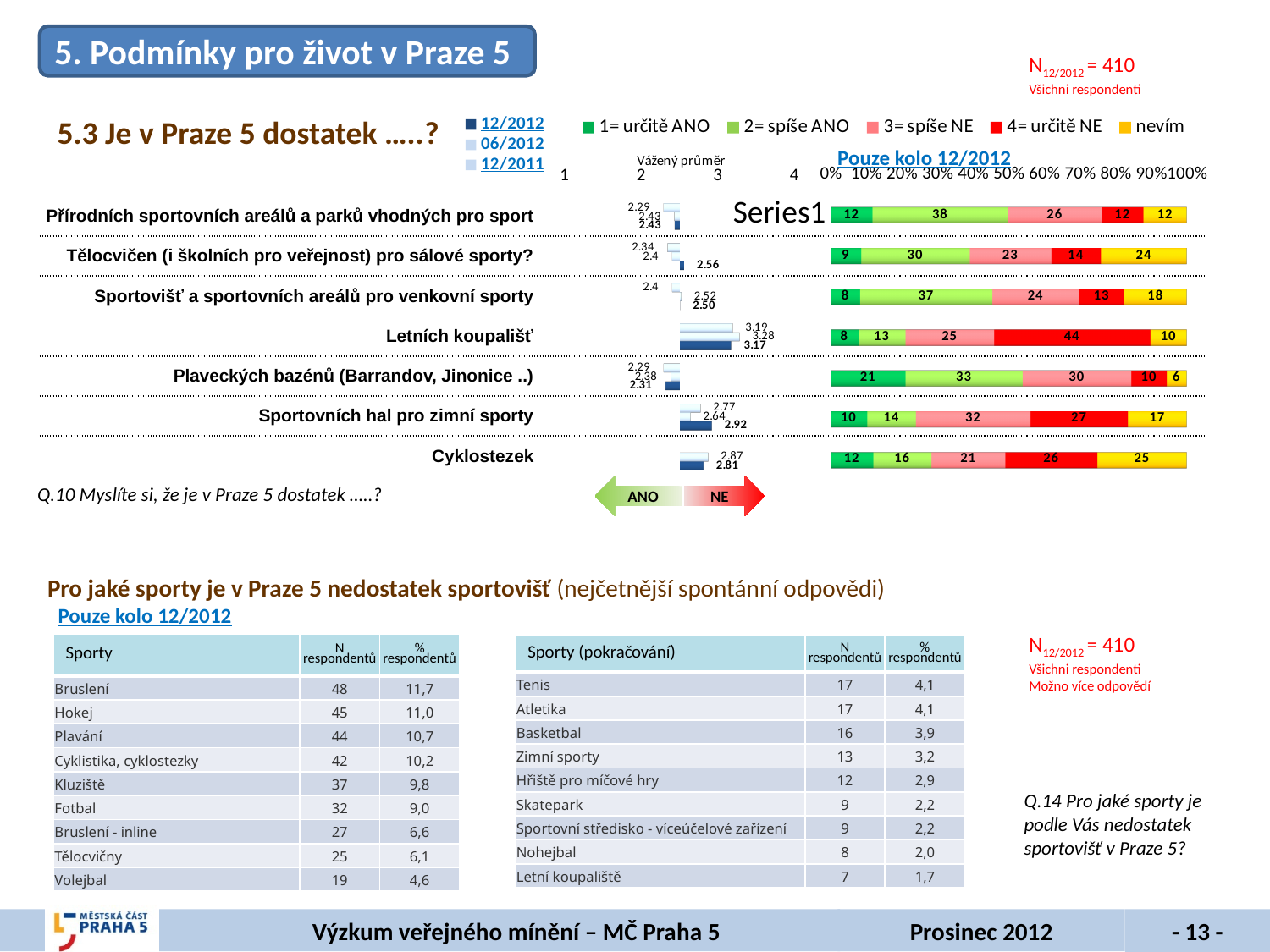
How many categories are shown in the stacked bar chart 'Pouze kolo 12/2012'? 7 In the stacked bar chart 'Pouze kolo 12/2012', which category has the lowest value for 'nevím'? Plaveckých bazénů (Barrandov, Jinonice ..) In the stacked bar chart 'Pouze kolo 12/2012', which category has the highest value for '2= spíše ANO'? Přírodních sportovních areálů a parků vhodných pro sport How many series does the legend of the stacked bar chart 'Pouze kolo 12/2012' list? 5 In the stacked bar chart 'Pouze kolo 12/2012', which has the larger 'nevím' value: 'Tělocvičen (i školních pro veřejnost) pro sálové sporty?' or 'Sportovišť a sportovních areálů pro venkovní sporty'? Tělocvičen (i školních pro veřejnost) pro sálové sporty? In the 'Vážený průměr' chart, which category has the highest weighted average values? Letních koupališť What type of chart is the 'Pouze kolo 12/2012' chart? bar chart In the stacked bar chart 'Pouze kolo 12/2012', what is the value for '3= spíše NE' for 'Sportovních hal pro zimní sporty'? 32 In the stacked bar chart 'Pouze kolo 12/2012', what percentage of respondents answered '4= určitě NE' for 'Letních koupališť'? 44 In the stacked bar chart 'Pouze kolo 12/2012', what is the value for '1= určitě ANO' for 'Plaveckých bazénů (Barrandov, Jinonice ..)'? 21 How many series does the legend of the 'Vážený průměr' chart list? 3 In the stacked bar chart 'Pouze kolo 12/2012', for 'Cyklostezek', how much larger is the '4= určitě NE' value than the '1= určitě ANO' value? 14